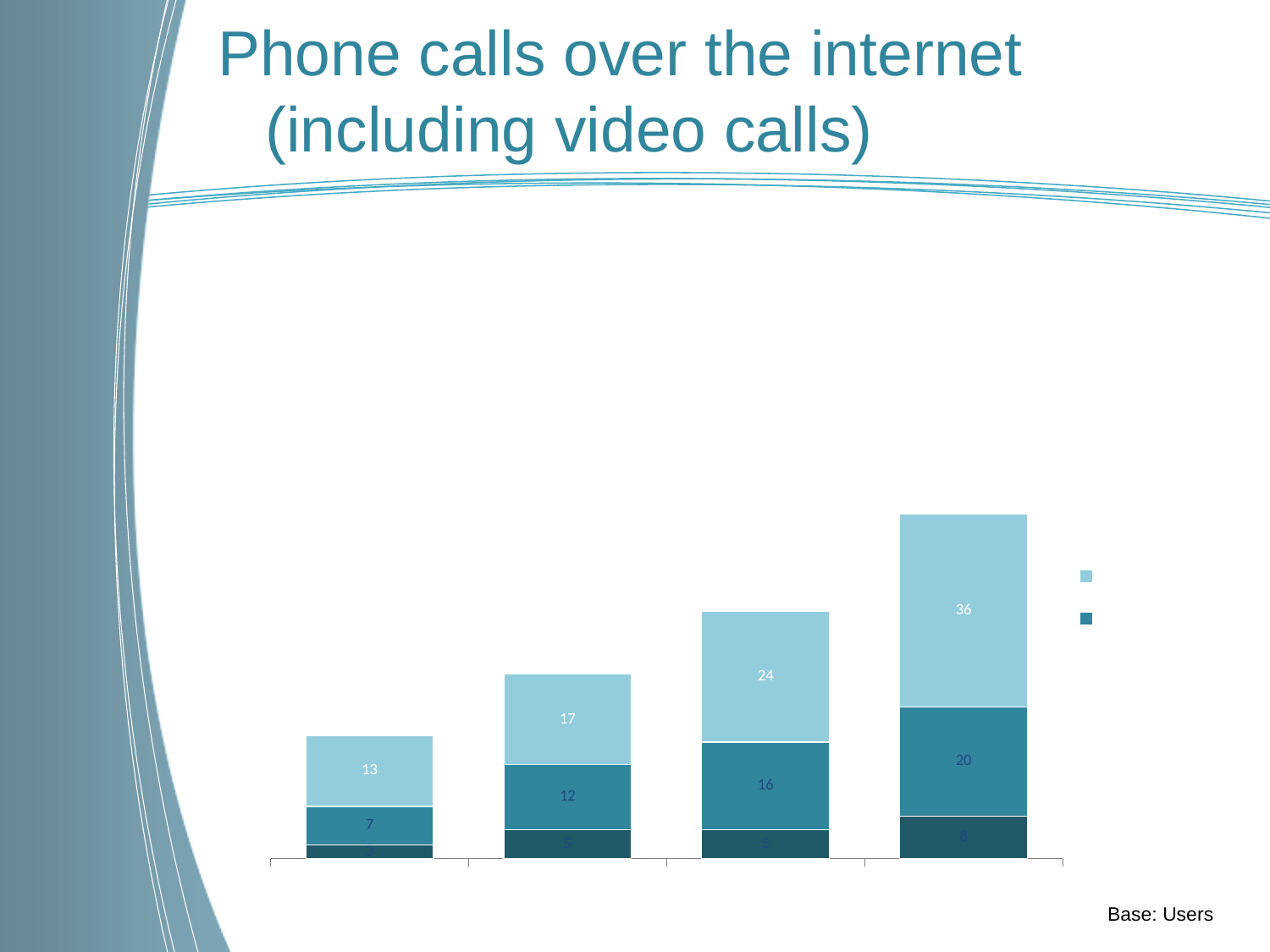
What is the value of the middle segment of the third bar from the left? 16 Do the total bar heights rise or fall from left to right? Rise What is the difference between the top segment of the fourth bar and the top segment of the third bar? 12 How many bars are plotted in the chart? 4 What is the title of the slide containing the chart? Phone calls over the internet (including video calls) Which bar has the largest top (light blue) segment? The rightmost (fourth) bar What is the value of the top segment of the leftmost bar? 13 What is the value of the top (light blue) segment of the rightmost bar? 36 What base note is printed below the chart? Base: Users What is the difference between the middle segment of the fourth bar and the middle segment of the third bar? 4 What kind of chart is shown on the slide? Stacked bar chart Which is larger: the middle segment of the second bar or the middle segment of the first bar? The second bar